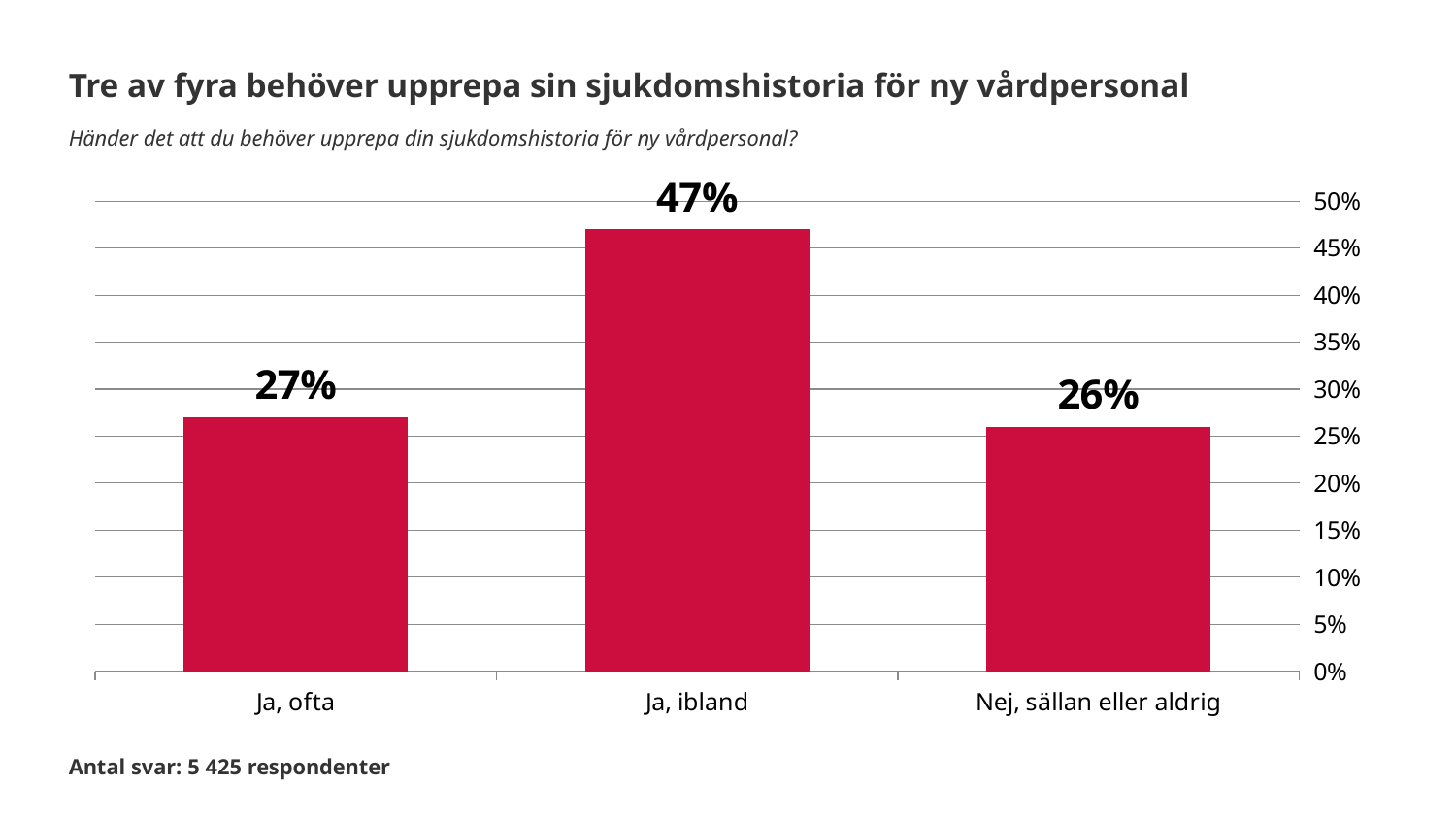
What kind of chart is shown on the slide? Bar chart What is the difference between the values for "Ja, ofta" and "Nej, sällan eller aldrig"? 1% What is the title of the chart on the slide? Tre av fyra behöver upprepa sin sjukdomshistoria för ny vårdpersonal Which is larger, the value for "Ja, ibland" or the value for "Nej, sällan eller aldrig"? Ja, ibland What is the value for "Ja, ibland"? 47% What is the difference between the values for "Ja, ibland" and "Ja, ofta"? 20% Is the value for "Nej, sällan eller aldrig" greater or less than 30%? less What is the value for "Nej, sällan eller aldrig"? 26% Is the value for "Ja, ibland" greater or less than 40%? greater Which category has the highest value? Ja, ibland How many categories are shown on the x axis? 3 What is the value for "Ja, ofta"? 27%